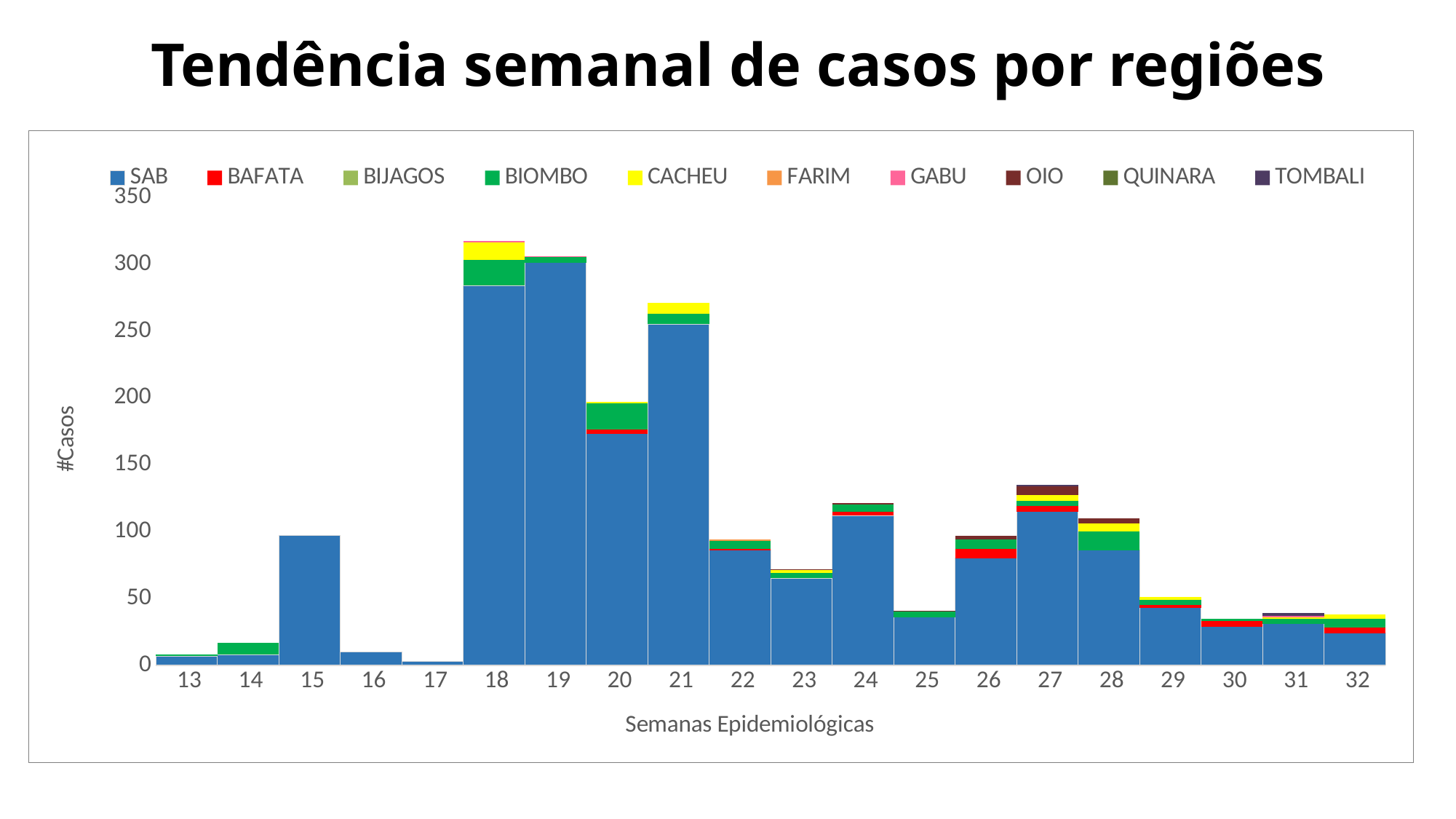
How many series does the legend list? 10 Which week has the highest SAB value? 19 How many epidemiological weeks are shown on the x axis? 20 What is the label of the y axis? #Casos Do the total values rise or fall from week 18 to week 20? fall Which week has the larger total, week 15 or week 24? 24 Which week has the lowest total number of cases? 17 Is the total value for week 21 greater or less than 250? greater Is the total value for week 27 greater or less than 100? greater What kind of chart is shown on the slide? Stacked bar chart Is the total value for week 25 greater or less than 50? less